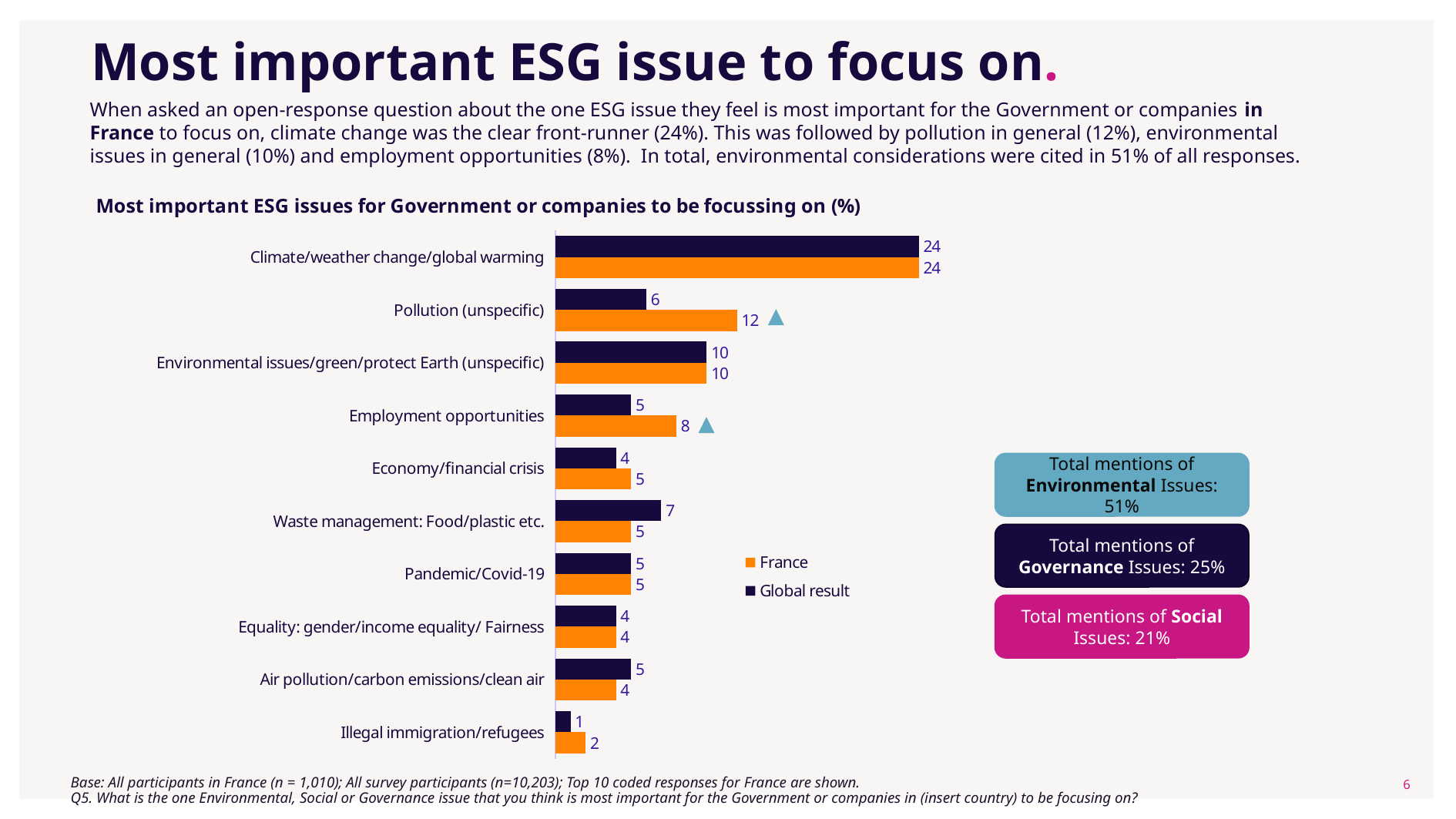
Which category has the lowest Global result value? Illegal immigration/refugees How many series does the legend list? 2 What is the Global result value for Waste management: Food/plastic etc.? 7 What is the France value for Pollution (unspecific)? 12 Which category has the highest France value? Climate/weather change/global warming How many categories are shown in the chart? 10 What kind of chart is shown on the slide? Bar chart Which colour represents the France series in the chart? Orange Which is larger for Waste management: Food/plastic etc., the France value or the Global result value? Global result What is the France value for Employment opportunities? 8 What is the title of the chart? Most important ESG issues for Government or companies to be focussing on (%) What is the difference between the France and Global result values for Pollution (unspecific)? 6